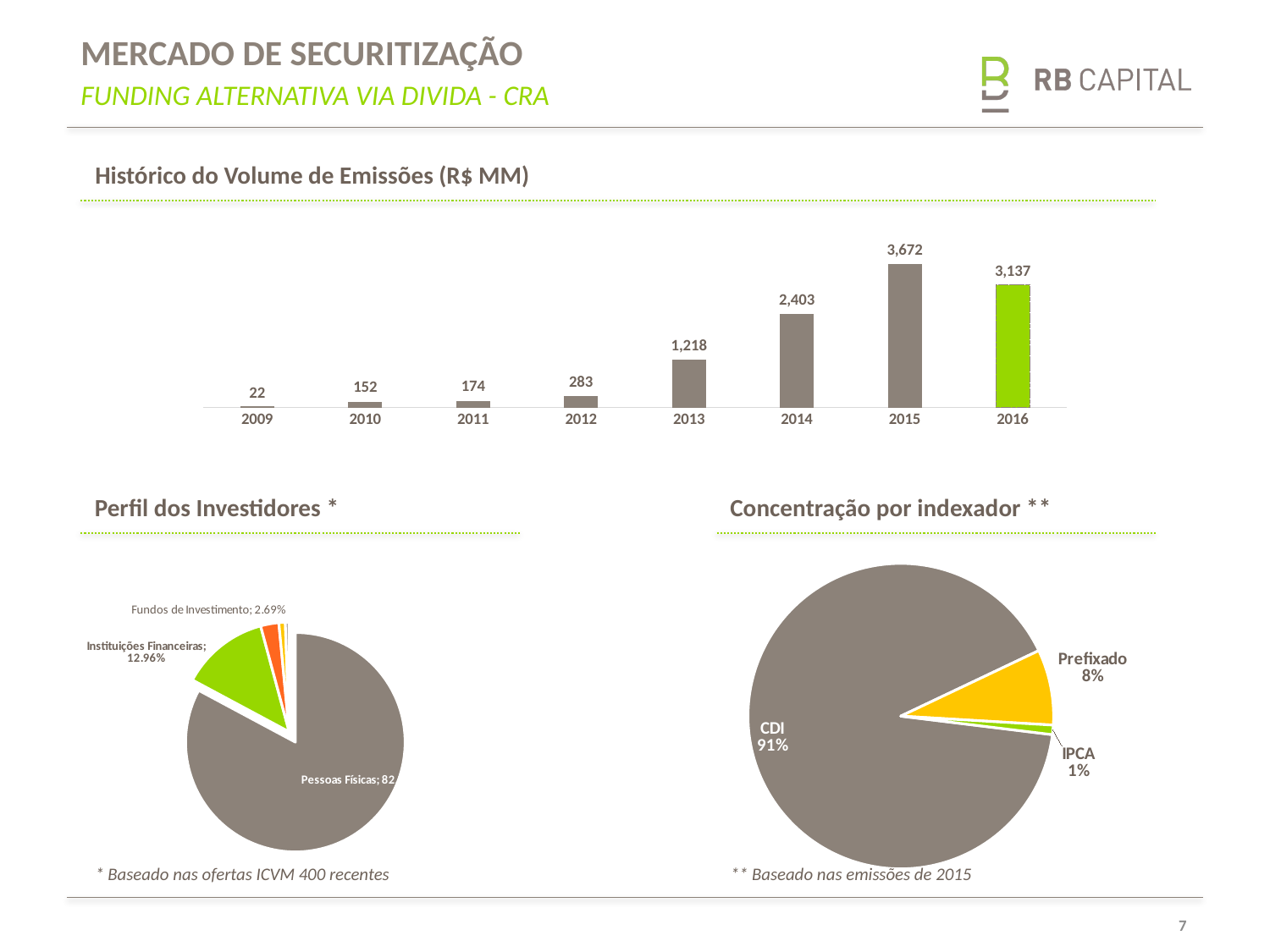
In the 'Histórico do Volume de Emissões (R$ MM)' chart, what is the value for 2015? 3,672 In the 'Histórico do Volume de Emissões (R$ MM)' chart, which year has the lowest value? 2009 How many years are shown in the 'Histórico do Volume de Emissões (R$ MM)' chart? 8 In the 'Histórico do Volume de Emissões (R$ MM)' chart, which year has the highest value? 2015 In the 'Histórico do Volume de Emissões (R$ MM)' chart, which is larger, the value for 2013 or the value for 2014? 2014 In the 'Histórico do Volume de Emissões (R$ MM)' chart, do the values rise or fall from 2009 to 2015? Rise In the 'Perfil dos Investidores *' pie chart, what share do Instituições Financeiras have? 12.96% In the 'Concentração por indexador **' pie chart, what share does Prefixado have? 8% In the 'Histórico do Volume de Emissões (R$ MM)' chart, what is the value for 2016? 3,137 In the 'Histórico do Volume de Emissões (R$ MM)' chart, what is the difference between the values for 2015 and 2016? 535 In the 'Concentração por indexador **' pie chart, what share does CDI have? 91% What kind of chart is 'Histórico do Volume de Emissões (R$ MM)'? Bar chart